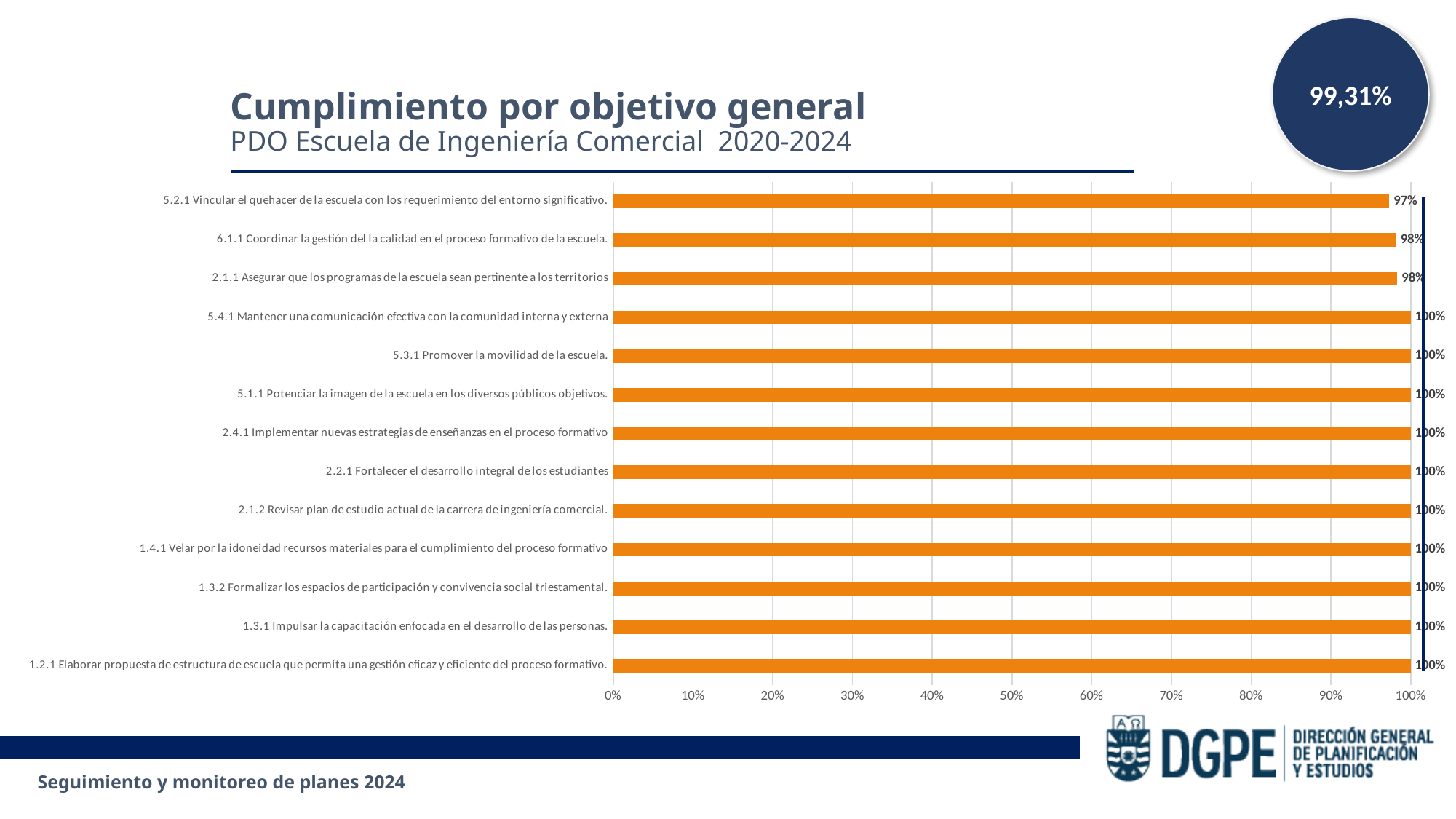
What is the value for objective 6.1.1 Coordinar la gestión del la calidad en el proceso formativo de la escuela? 98% What kind of chart is shown on the slide? bar chart What is the title of the chart on the slide? Cumplimiento por objetivo general What is the difference between the value for objective 6.1.1 and the value for objective 5.2.1? 1% What is the value for objective 5.2.1 Vincular el quehacer de la escuela con los requerimiento del entorno significativo? 97% Which is larger: the value for objective 2.1.1 or the value for objective 5.2.1? 2.1.1 What is the difference between the value for objective 1.2.1 and the value for objective 5.2.1? 3% Which objective has the lowest value in the chart? 5.2.1 Vincular el quehacer de la escuela con los requerimiento del entorno significativo. What is the value for objective 2.1.1 Asegurar que los programas de la escuela sean pertinente a los territorios? 98% What is the value for objective 5.3.1 Promover la movilidad de la escuela? 100% How many objectives (categories) are plotted in the chart? 13 Is the value for objective 5.2.1 greater or less than 90%? greater